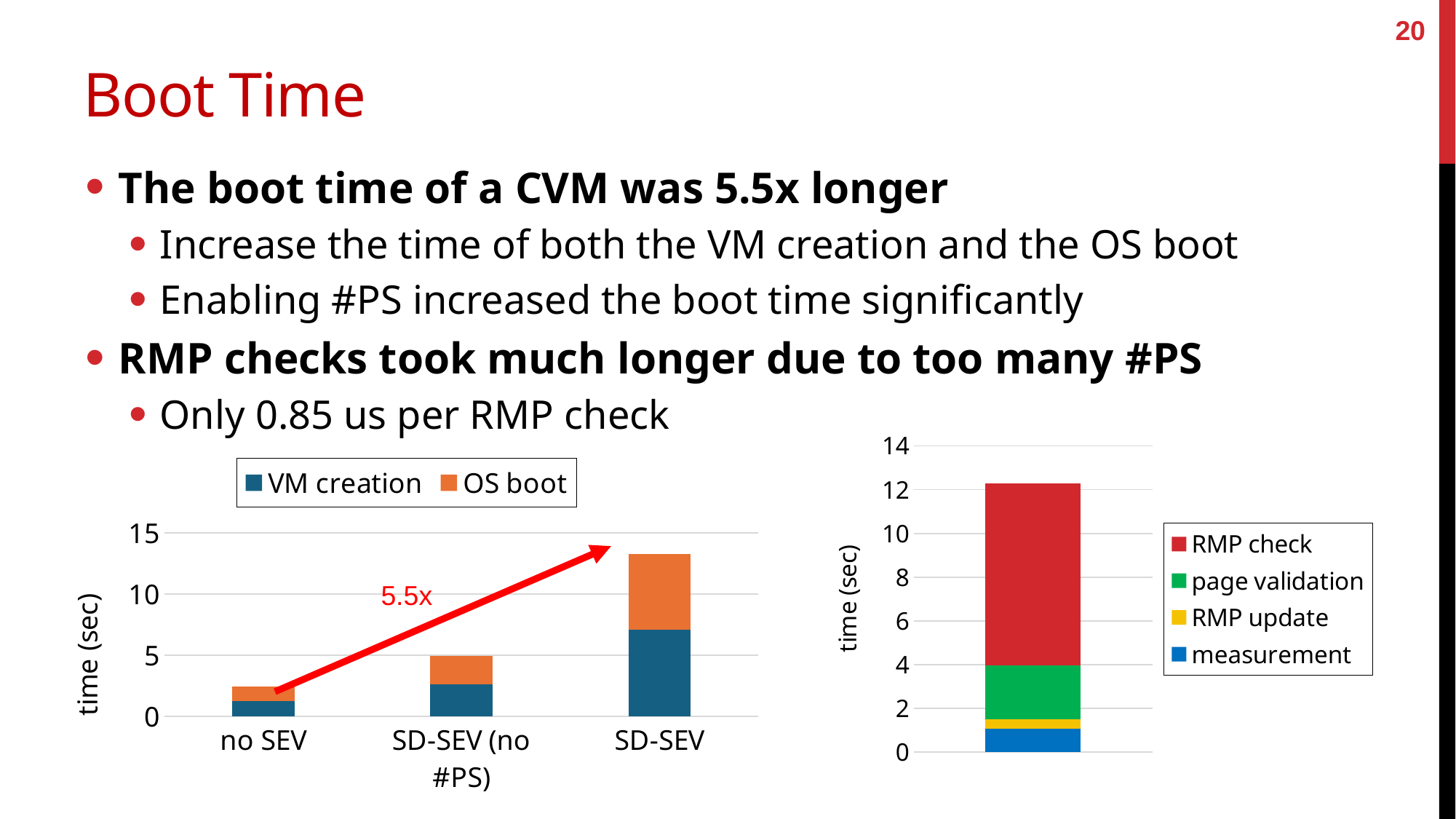
In the left chart, do the total boot times rise or fall from no SEV to SD-SEV? rise In the right chart, how many series does the legend list? 4 In the right chart, which series takes up the largest portion of the bar? RMP check In the left chart, how many categories are shown on the x axis? 3 In the left chart, how many series does the legend list? 2 In the left chart, what multiplier is annotated on the red arrow between no SEV and SD-SEV? 5.5x In the left chart, is the total value for SD-SEV greater or less than 10? greater In the left chart, which category has the highest total boot time? SD-SEV In the left chart, which category has the lowest total boot time? no SEV In the left chart, is the total value for no SEV greater or less than 5? less In the right chart, is the total height of the stacked bar greater or less than 10? greater In the left chart, what kind of chart is shown? stacked bar chart